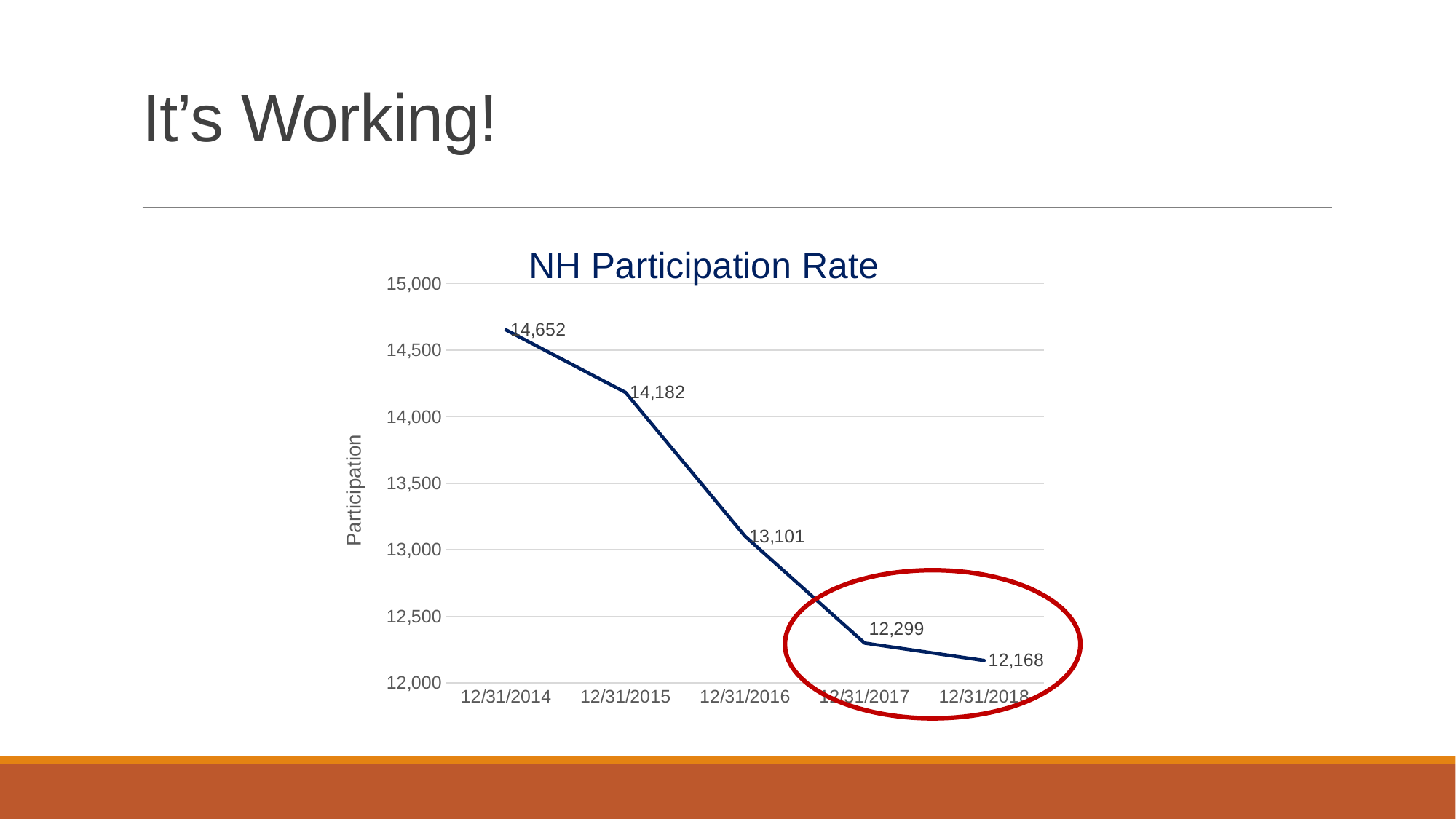
Is the value for 12/31/2017 greater or less than 12,500? less What kind of chart is shown on the slide? line chart Which date has the highest participation value? 12/31/2014 How many data points are plotted on the chart? 5 What is the value for 12/31/2018? 12,168 Do the values rise or fall from 12/31/2014 to 12/31/2018? fall Which is larger, the value for 12/31/2015 or the value for 12/31/2016? 12/31/2015 What is the difference between the values for 12/31/2017 and 12/31/2018? 131 What is the value for 12/31/2016? 13,101 What is the difference between the values for 12/31/2014 and 12/31/2015? 470 Which date has the lowest participation value? 12/31/2018 What is the value for 12/31/2014? 14,652